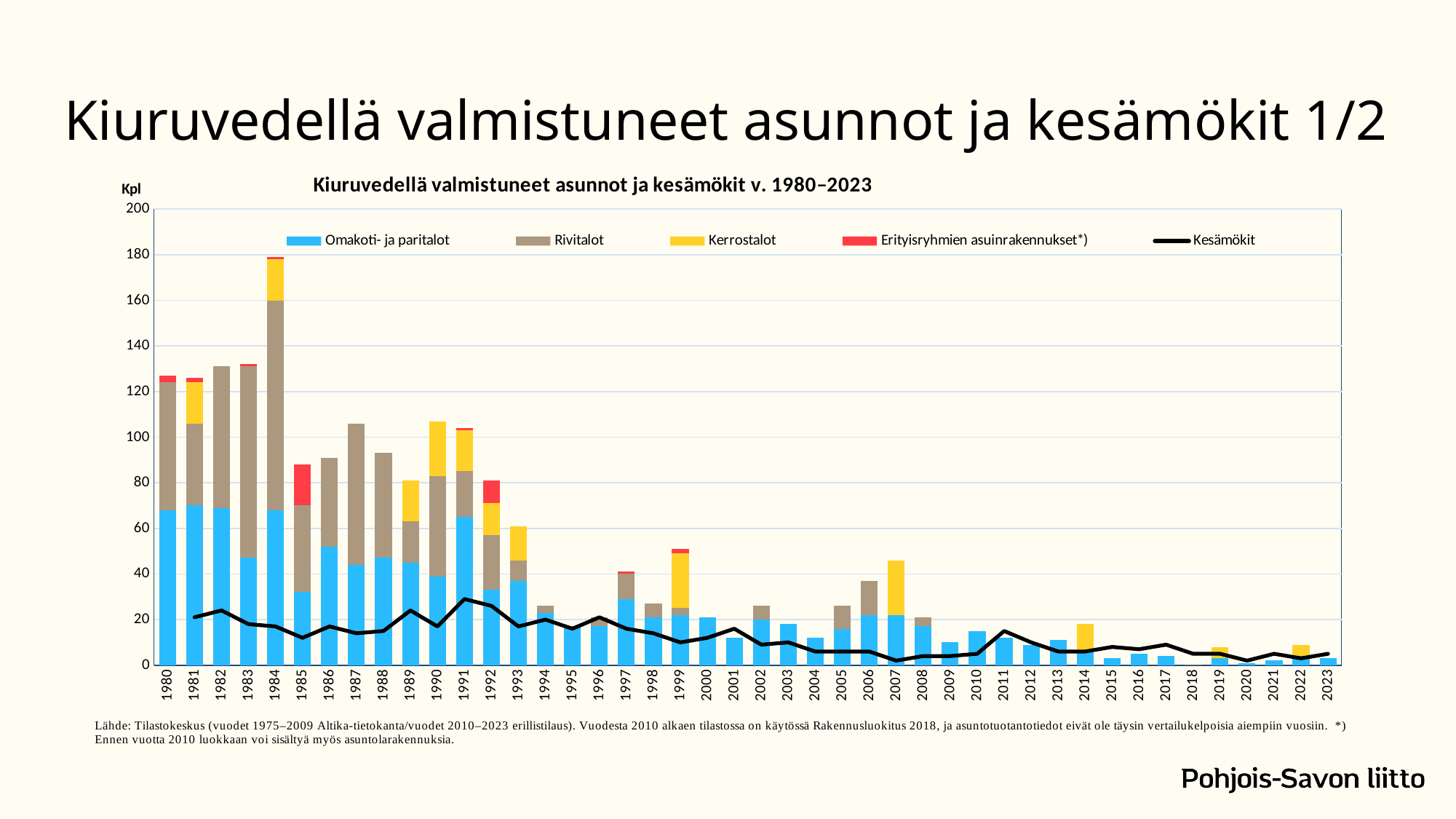
How many years are shown on the x axis? 44 Which year has a larger total stacked bar, 1980 or 2000? 1980 What kind of chart is shown on the slide? combination bar and line chart (stacked bars with a line) Is the total stacked bar for 2023 greater or less than 20? less In which year does the Kesämökit line reach its highest point? 1991 How many series does the legend list? 5 Is the total stacked bar for 1982 greater or less than 120? greater Overall, do the total stacked bars rise or fall from 1980 to 2023? fall Which year has a larger total stacked bar, 1984 or 1985? 1984 What is the title of the chart? Kiuruvedellä valmistuneet asunnot ja kesämökit v. 1980–2023 Is the total stacked bar for 1984 greater or less than 160? greater Which year has the highest total stacked bar? 1984